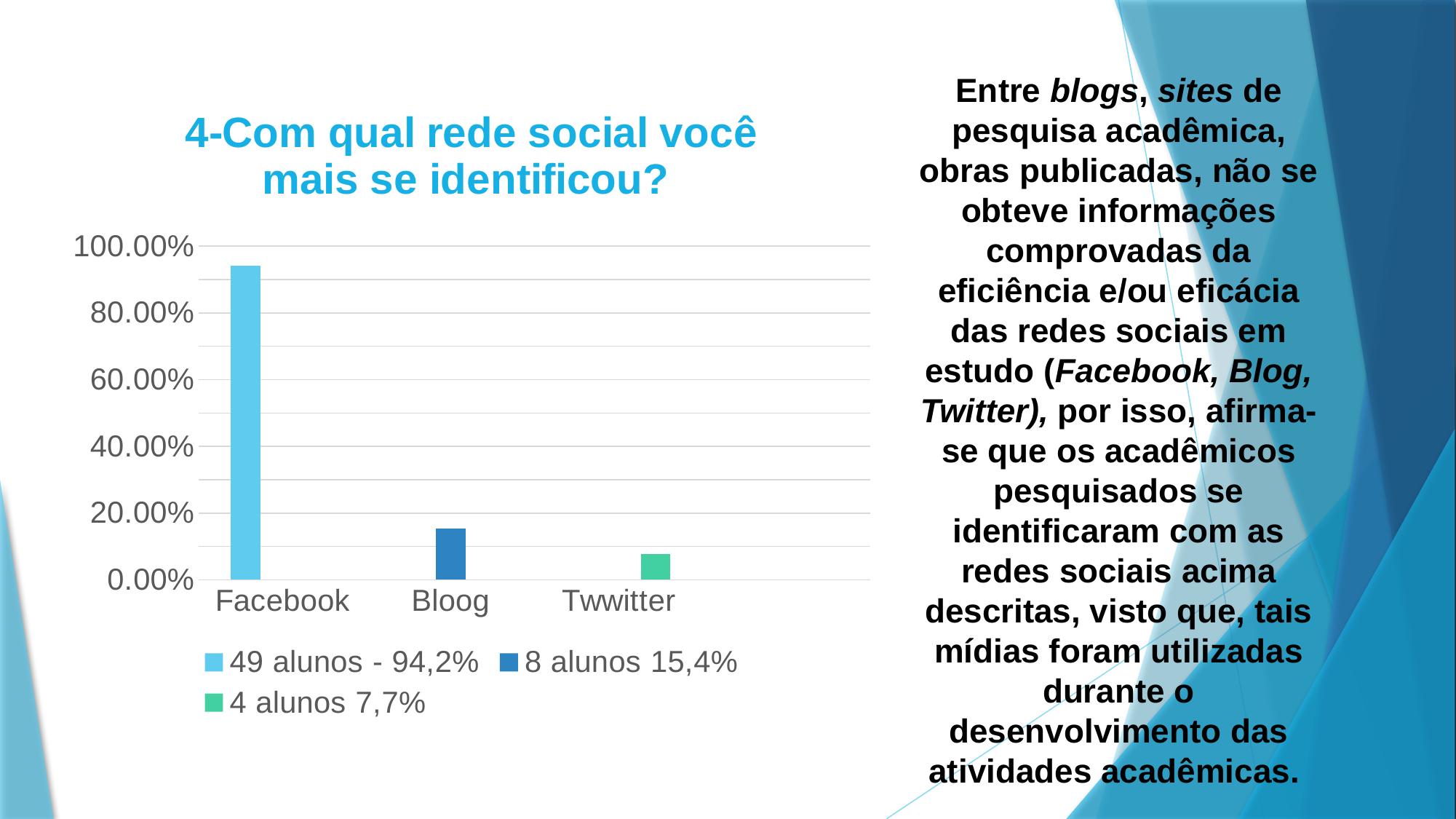
Is the value for Bloog greater or less than 20.00%? less Which category has the lowest bar in the chart? Twwitter Is the value for Facebook greater or less than 80.00%? greater What kind of chart is shown on the slide? bar chart What is the title of the chart? 4-Com qual rede social você mais se identificou? Which has the larger value, Bloog or Twwitter? Bloog Which category has the highest bar in the chart? Facebook Is the value for Twwitter greater or less than 20.00%? less How many categories are shown on the x axis of the chart? 3 How many series does the chart's legend list? 3 What does the first legend entry (light blue) say? 49 alunos - 94,2% Do the bar values rise or fall from left to right across the x axis? fall